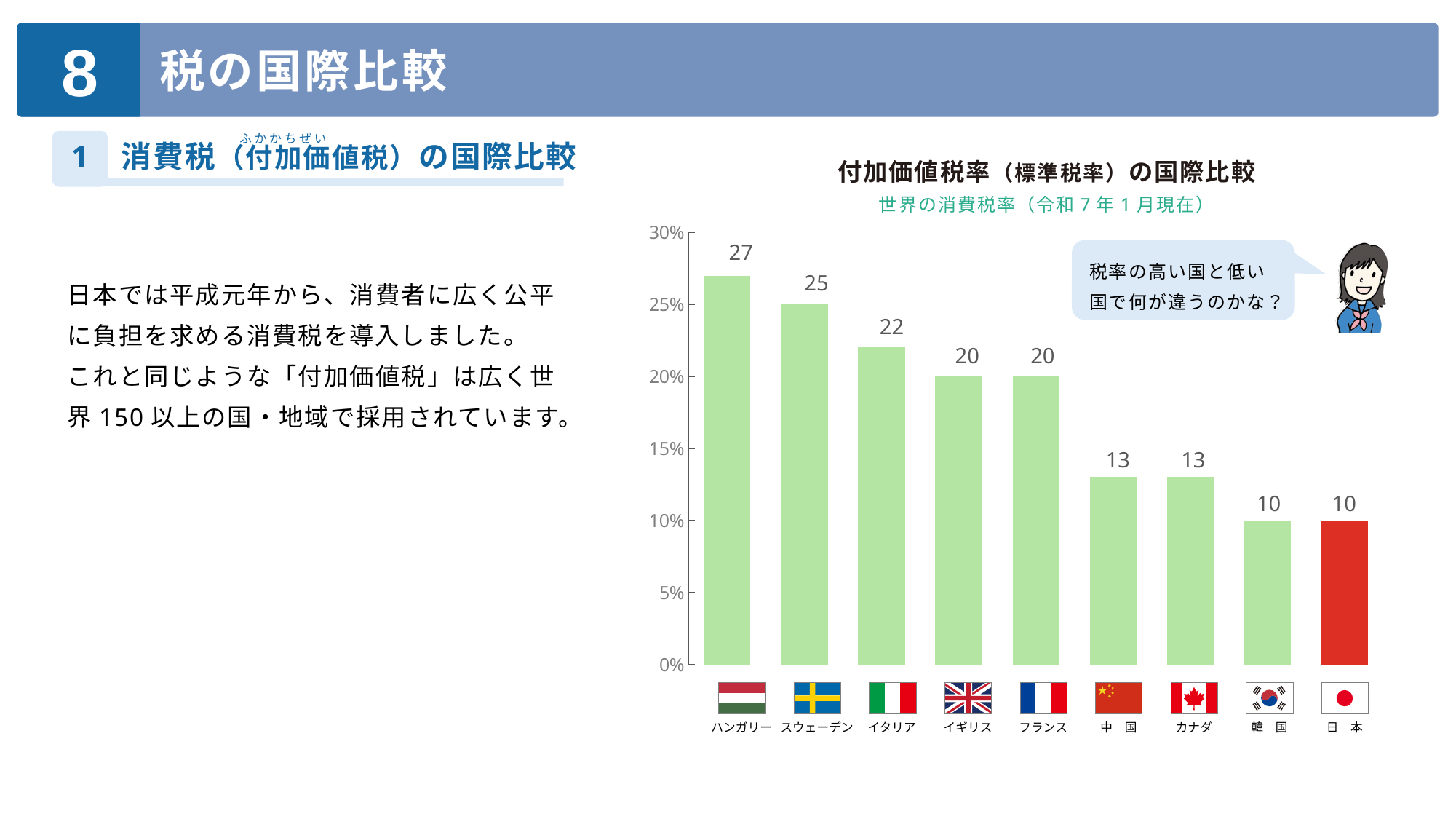
What is the difference between the values for スウェーデン (Sweden) and イギリス (UK)? 5 How many countries are shown in the chart? 9 What is the value shown for 日本 (Japan) in the chart? 10 Which country's bar is coloured red instead of green? 日本 Which country has the highest value in the chart? ハンガリー Which is larger, the value for スウェーデン (Sweden) or the value for カナダ (Canada)? スウェーデン What kind of chart is shown on the slide? bar chart What is the value shown for イタリア (Italy) in the chart? 22 What is the value shown for 中国 (China) in the chart? 13 What is the value shown for ハンガリー (Hungary) in the chart? 27 Is the value for フランス (France) greater or less than 15%? greater What is the difference between the values for ハンガリー (Hungary) and 日本 (Japan)? 17